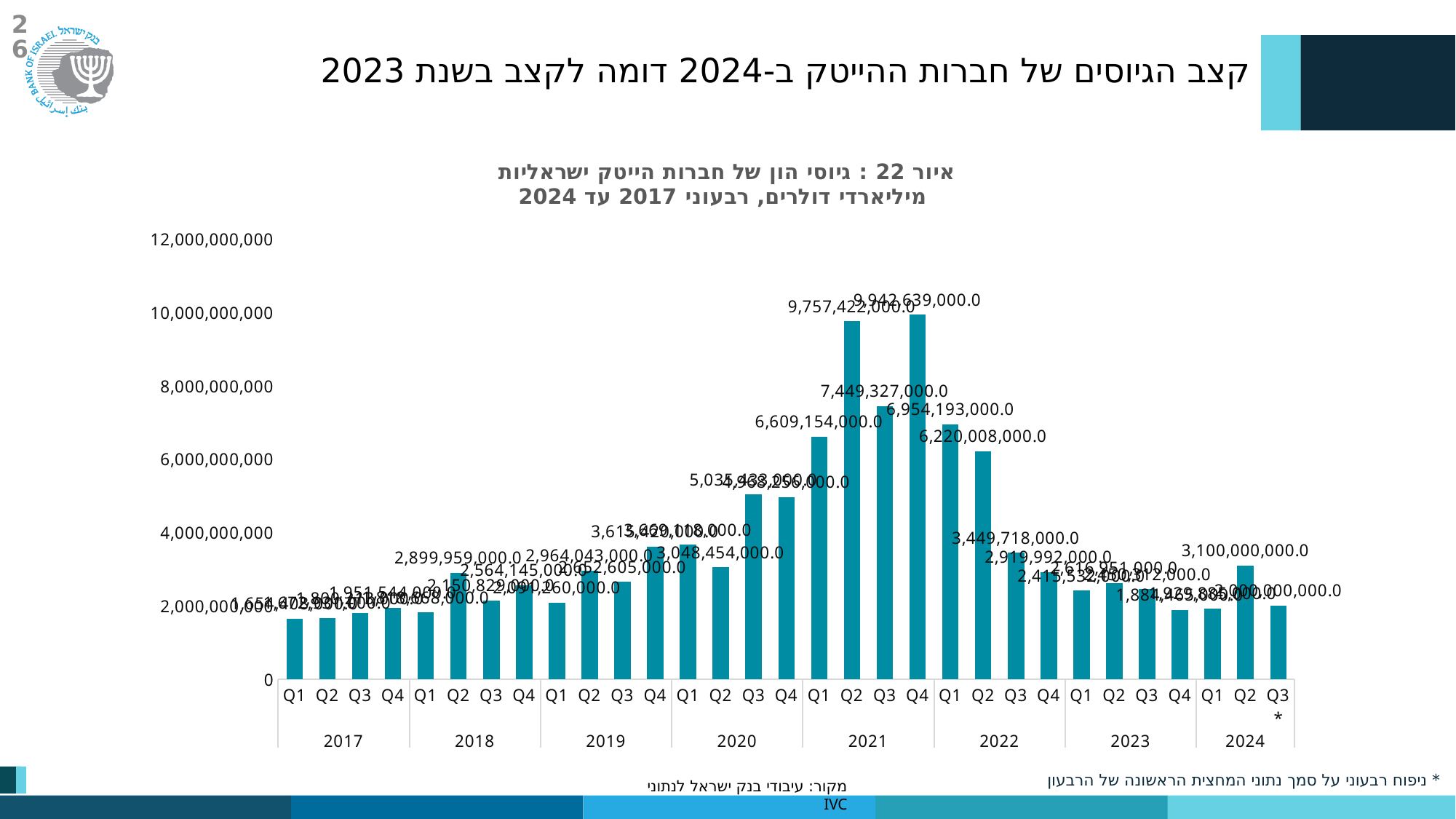
Is the value for Q3 2020 greater or less than 4,000,000,000? greater What is the value for Q2 2021? 9,757,422,000.0 What is the difference between the values for Q2 2024 and Q3 2024? 1,100,000,000.0 What is the value for Q4 2021? 9,942,639,000.0 Which is larger, the value for Q3 2021 or the value for Q1 2022? Q3 2021 What type of chart is shown on the slide? bar chart What is the difference between the values for Q1 2022 and Q2 2022? 734,185,000.0 Which quarter has the highest value? Q4 2021 What is the value for Q1 2022? 6,954,193,000.0 What is the value for Q2 2024? 3,100,000,000.0 How many years are shown on the x axis? 8 Do the values rise or fall from Q1 2022 to Q4 2022? fall